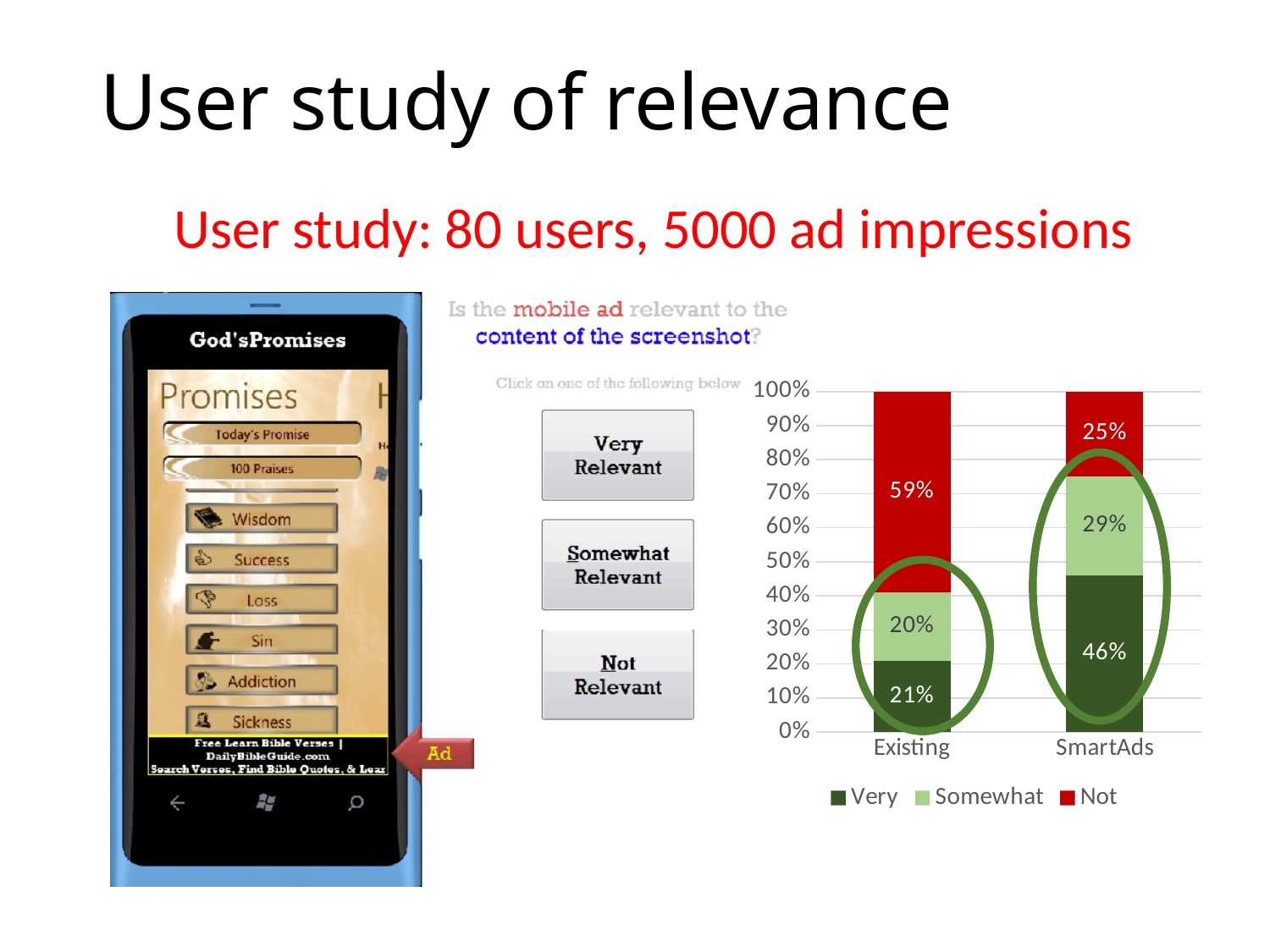
Which colour represents the Not relevant series in the chart? Red What percentage of ad impressions were rated Not relevant for Existing ads? 59% How many series does the chart legend list? 3 Which category has the lower Not relevant share? SmartAds What is the difference between the Very relevant values for SmartAds and Existing? 25% What is the Not relevant value for SmartAds? 25% How many categories are shown on the x axis of the chart? 2 What is the difference between the Not relevant values for Existing and SmartAds? 34% What kind of chart is shown on the slide? Stacked bar chart What percentage of ad impressions were rated Very relevant for SmartAds? 46% Which category has the higher Very relevant share, Existing or SmartAds? SmartAds What is the Somewhat relevant value for the Existing category? 20%